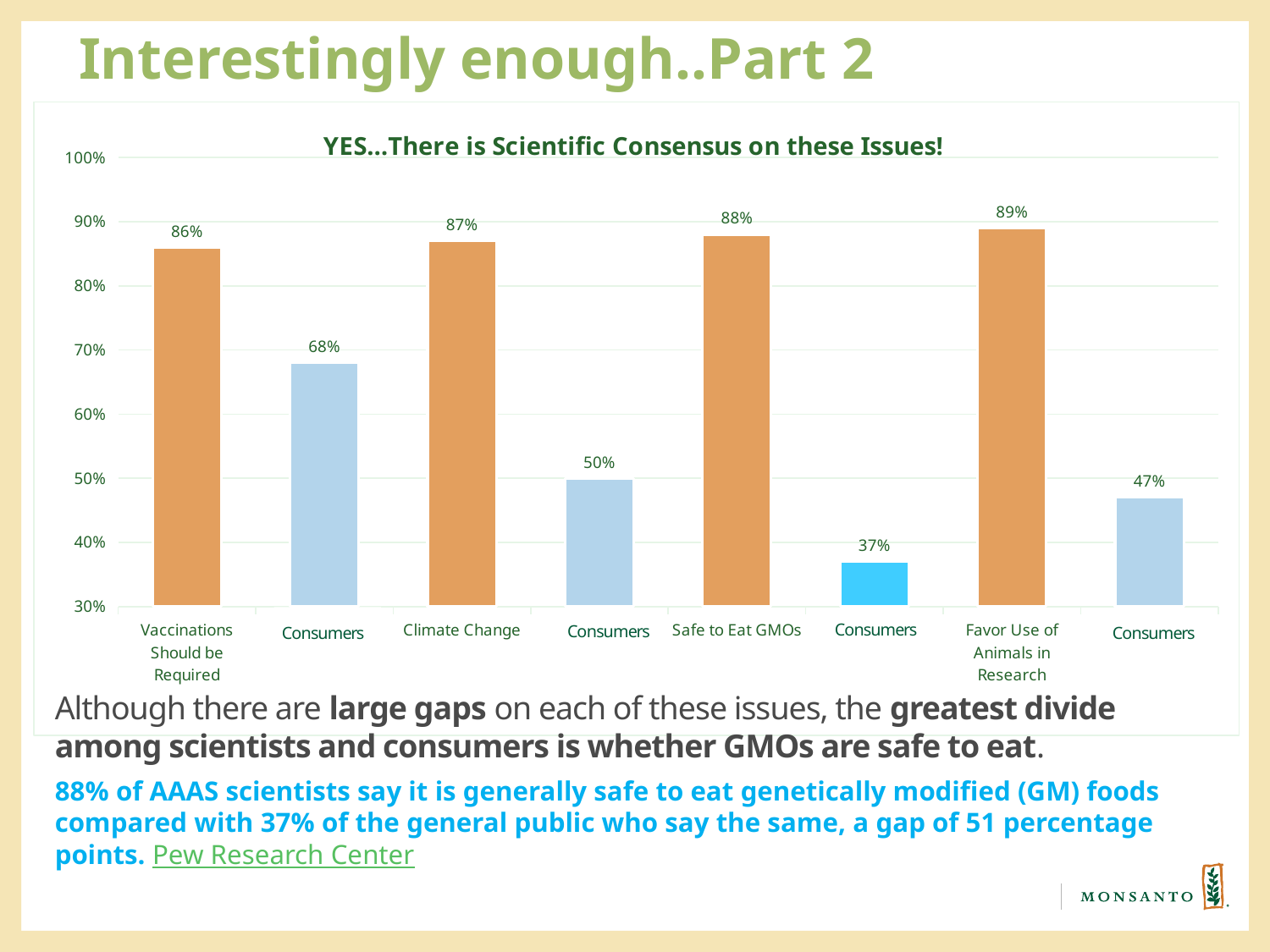
What is the value of the Consumers bar immediately to the right of Climate Change? 50% What is the value for Safe to Eat GMOs? 88% What is the value of the Consumers bar immediately to the right of Safe to Eat GMOs? 37% What is the title of the chart? YES...There is Scientific Consensus on these Issues! What is the difference between Safe to Eat GMOs (88%) and the Consumers bar next to it (37%)? 51 percentage points Which is larger: the Consumers bar next to Vaccinations Should be Required or the Consumers bar next to Favor Use of Animals in Research? The Consumers bar next to Vaccinations Should be Required How many bars are plotted on the chart? 8 What is the value for Vaccinations Should be Required? 86% Which bar has the highest value? Favor Use of Animals in Research What kind of chart is shown on the slide? Bar chart What is the difference between Climate Change and the Consumers bar immediately to its right? 37 percentage points What is the lowest value shown on the chart? 37%